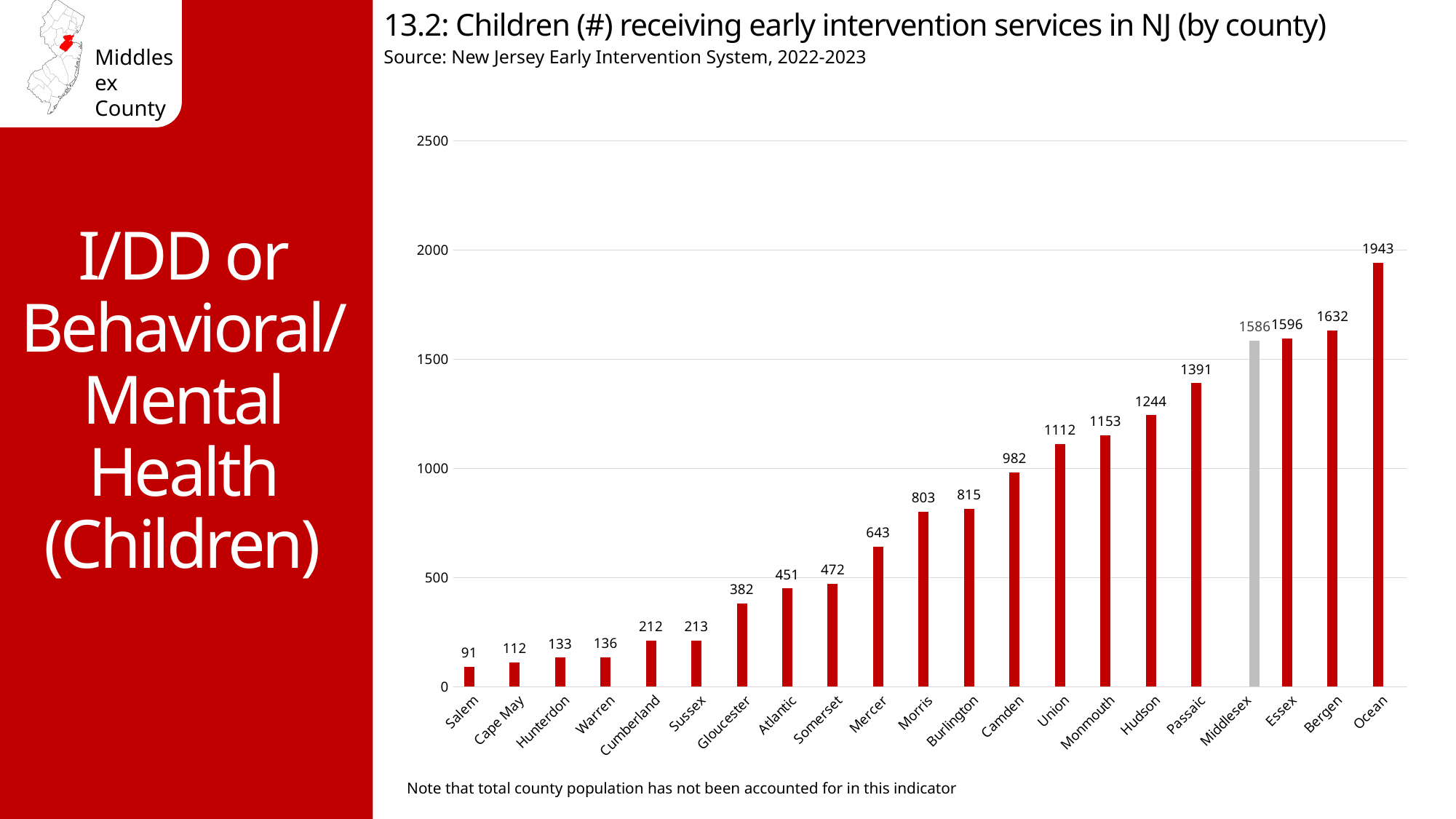
Which county has the highest number of children receiving early intervention services? Ocean How many children are receiving early intervention services in Middlesex County? 1586 Is the value for Passaic greater or less than 1500? less What is the value shown for Ocean County? 1943 What kind of chart is shown on the slide? Bar chart Which has a higher value, Camden or Union? Union How many counties are shown on the chart? 21 Which county's bar is shown in grey rather than red? Middlesex What is the value shown for Salem County? 91 What is the difference between the values for Bergen and Essex? 36 Which county has the lowest number of children receiving early intervention services? Salem What is the difference between the values for Ocean and Middlesex? 357